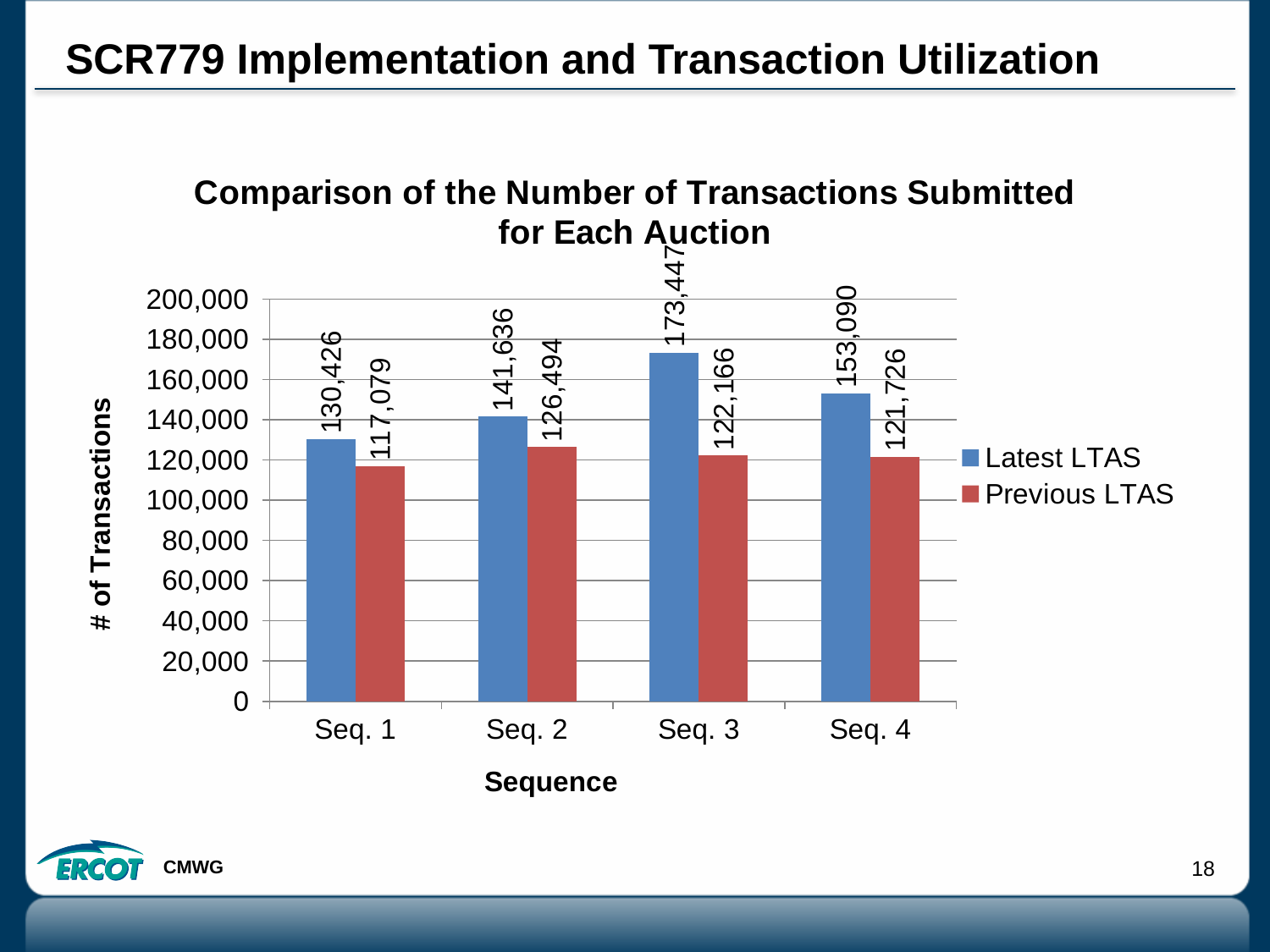
Which sequence has the lowest Previous LTAS value? Seq. 1 What is the Latest LTAS value for Seq. 3? 173,447 Which sequence has the highest Latest LTAS value? Seq. 3 What is the difference between the Latest LTAS and Previous LTAS values for Seq. 3? 51,281 How many series does the legend list? 2 What is the label of the y axis? # of Transactions What is the Previous LTAS value for Seq. 1? 117,079 What kind of chart is shown on the slide? Bar chart Is the Latest LTAS value for Seq. 1 greater or less than 120,000? greater What is the Latest LTAS value for Seq. 4? 153,090 Which is larger for Seq. 2: the Latest LTAS value or the Previous LTAS value? Latest LTAS How many sequences are shown on the x axis? 4